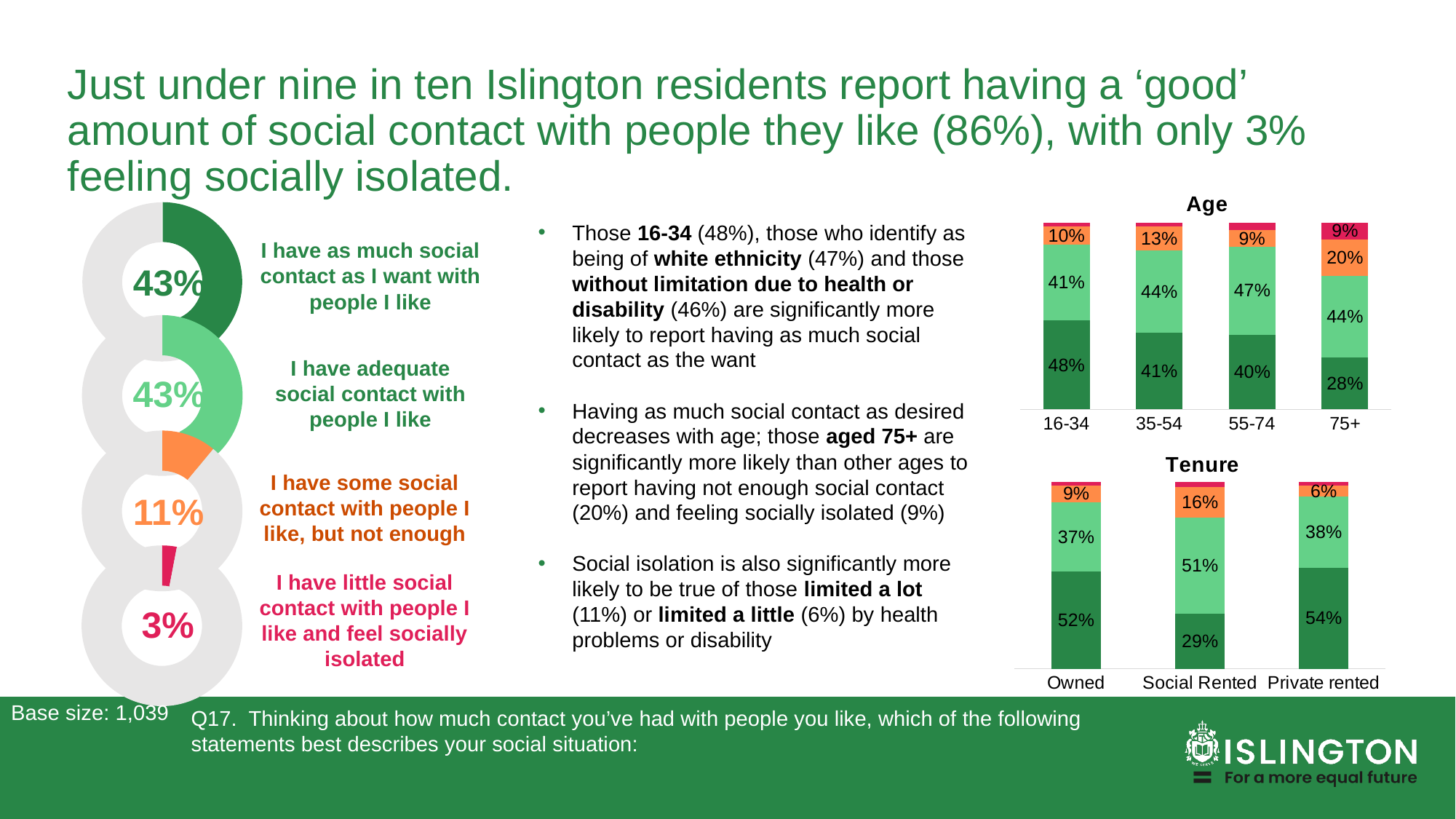
In the Tenure chart, is the orange segment larger for Owned or for Social Rented? Social Rented How many age groups are shown in the Age chart? 4 In the Age chart, what is the value of the orange segment for the 75+ group? 20% In the Age chart, which age group has the highest dark green (bottom) segment value? 16-34 In the Age chart, what is the value of the dark green (bottom) segment for the 16-34 group? 48% In the chart on the left of the slide, what percentage of residents say they have little social contact with people they like and feel socially isolated? 3% In the Age chart, which age group has the lowest dark green (bottom) segment value? 75+ In the Tenure chart, which tenure group has the highest light green (middle) segment value? Social Rented In the Age chart, what is the difference between the dark green segment values for 16-34 and 75+? 20 percentage points In the Tenure chart, what is the value of the dark green (bottom) segment for Social Rented? 29% How many tenure categories are shown in the Tenure chart? 3 What type of chart is the Age chart? Stacked bar chart